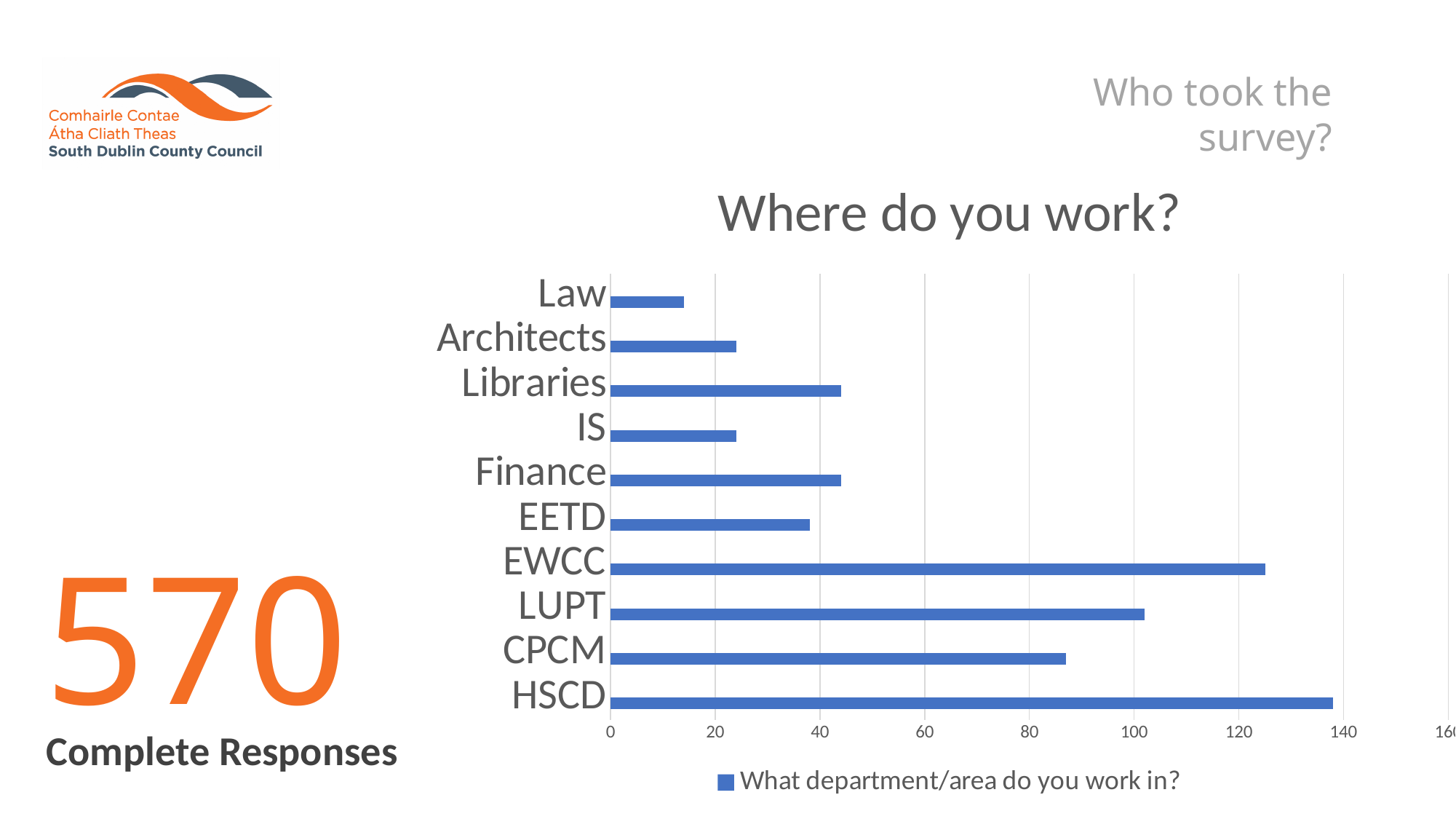
Is the value for HSCD greater or less than 120? greater What kind of chart is shown on the slide? bar chart Is the value for Law greater or less than 20? less Is the value for EWCC greater or less than 100? greater Which is larger, the value for EWCC or the value for LUPT? EWCC Which is larger, the value for CPCM or the value for LUPT? LUPT Which department has the highest value in the "Where do you work?" chart? HSCD What is the title of the chart? Where do you work? How many departments are listed on the y axis of the chart? 10 Which department has the lowest value in the "Where do you work?" chart? Law How many series does the chart legend list? 1